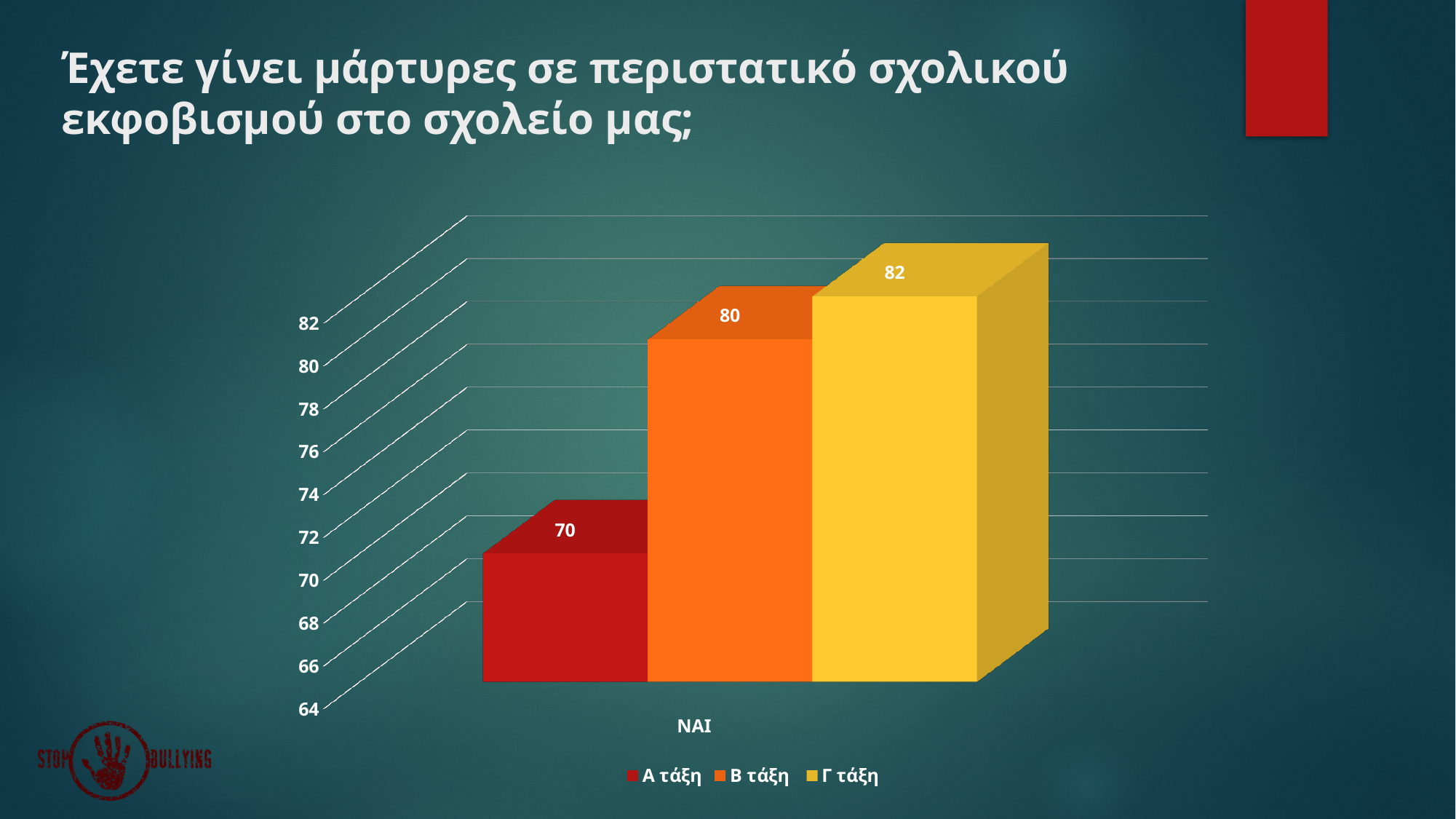
What kind of chart is shown on the slide? bar chart Which series has the lowest value? Α τάξη What colour is the bar for Γ τάξη? yellow How many series does the legend list? 3 What is the value for Β τάξη? 80 Which series has the highest value? Γ τάξη What is the value for Α τάξη? 70 What is the difference between the values for Γ τάξη and Α τάξη? 12 What is the difference between the values for Β τάξη and Α τάξη? 10 Which is larger, the value for Α τάξη or the value for Β τάξη? Β τάξη What is the value for Γ τάξη? 82 What is the category label shown on the x axis? ΝΑΙ